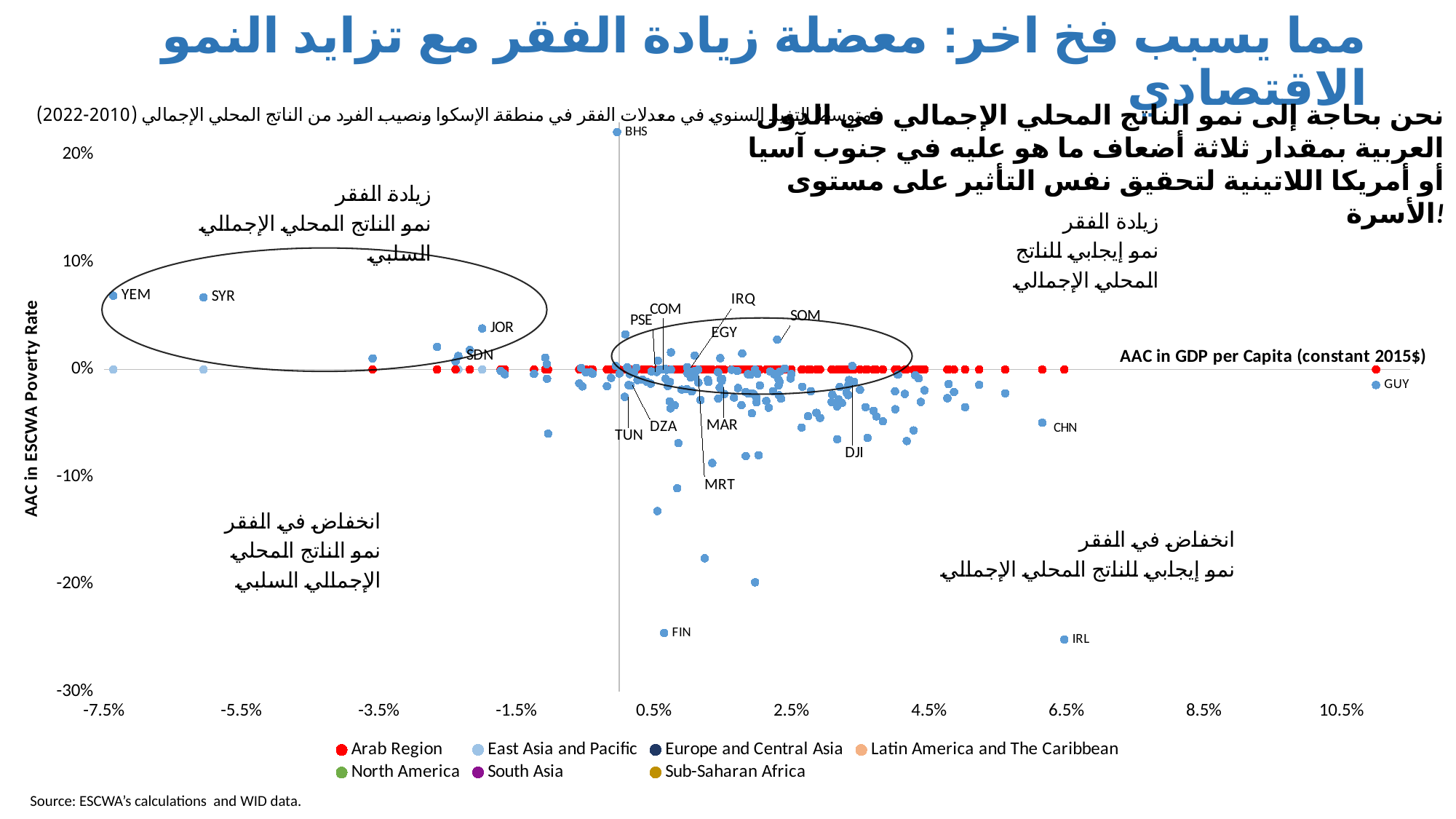
Which has the higher GDP per capita value, YEM or GUY? GUY Is the GDP per capita value for GUY greater or less than 8.5%? greater How many series does the chart legend list? 7 What is the label of the horizontal axis of the chart? AAC in GDP per Capita (constant 2015$) Is the GDP per capita value for YEM greater or less than -5.5%? less What is the label of the vertical axis of the chart? AAC in ESCWA Poverty Rate Which labeled point has the highest poverty rate value on the chart? BHS Is the poverty rate value for FIN greater or less than -20%? less Which has the higher poverty rate value, YEM or FIN? YEM What kind of chart is shown on the slide? Scatter chart